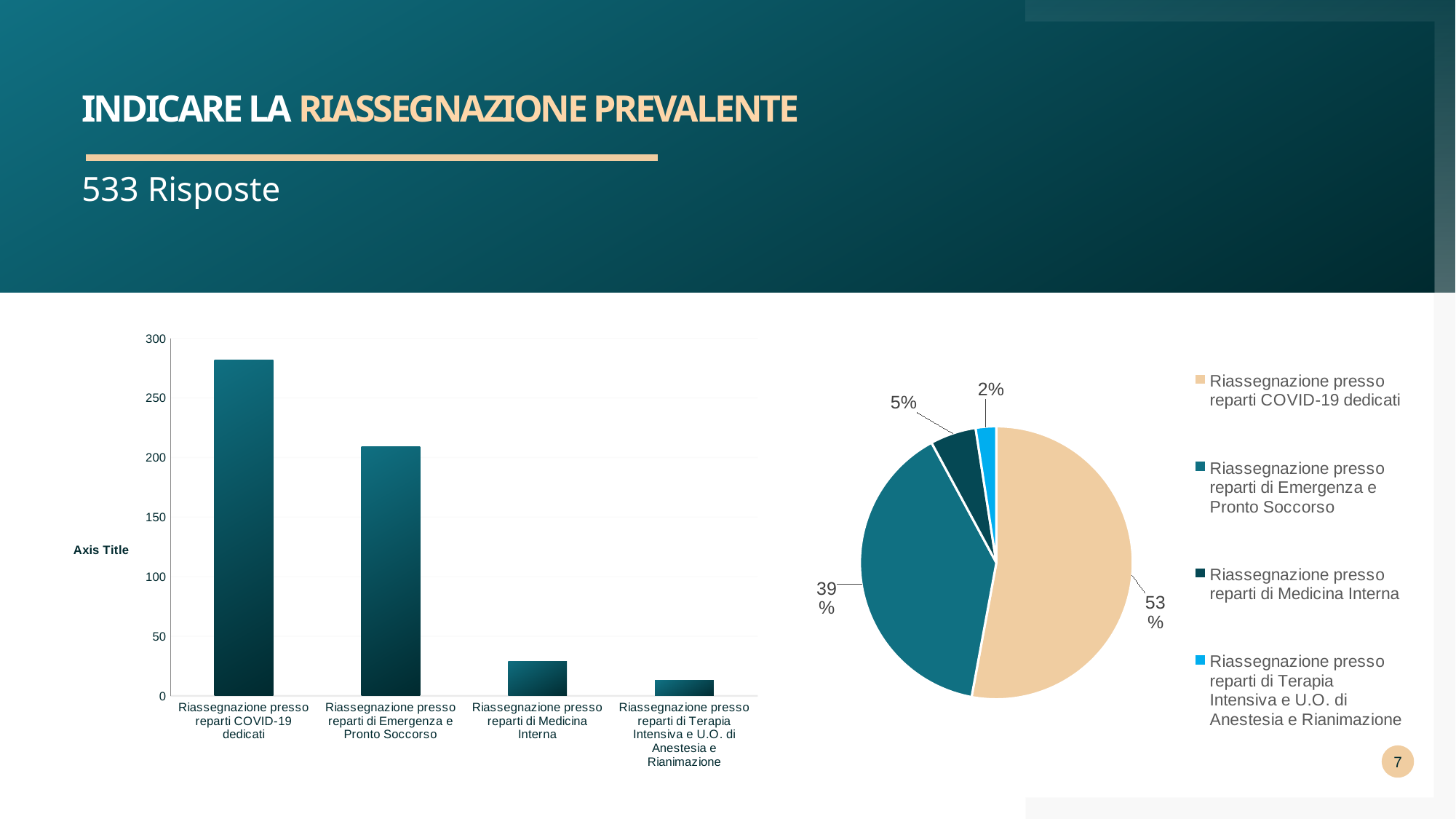
In the bar chart on the left, how many categories are shown? 4 In the bar chart on the left, is the value for Riassegnazione presso reparti di Emergenza e Pronto Soccorso greater or less than 250? less In the bar chart on the left, which category has the highest value? Riassegnazione presso reparti COVID-19 dedicati How many entries does the legend of the pie chart on the right list? 4 In the bar chart on the left, which category has the lowest value? Riassegnazione presso reparti di Terapia Intensiva e U.O. di Anestesia e Rianimazione In the bar chart on the left, is the value for Riassegnazione presso reparti COVID-19 dedicati greater or less than 250? greater What kind of chart is the chart on the left of the slide? bar chart In the pie chart on the right, what is the difference between the share for Riassegnazione presso reparti COVID-19 dedicati and the share for Riassegnazione presso reparti di Medicina Interna? 48% In the bar chart on the left, which is larger: the value for Riassegnazione presso reparti di Medicina Interna or the value for Riassegnazione presso reparti di Terapia Intensiva e U.O. di Anestesia e Rianimazione? Riassegnazione presso reparti di Medicina Interna What kind of chart is the chart on the right of the slide? pie chart In the pie chart on the right, what share does Riassegnazione presso reparti di Emergenza e Pronto Soccorso have? 39% In the bar chart on the left, is the value for Riassegnazione presso reparti di Medicina Interna greater or less than 50? less